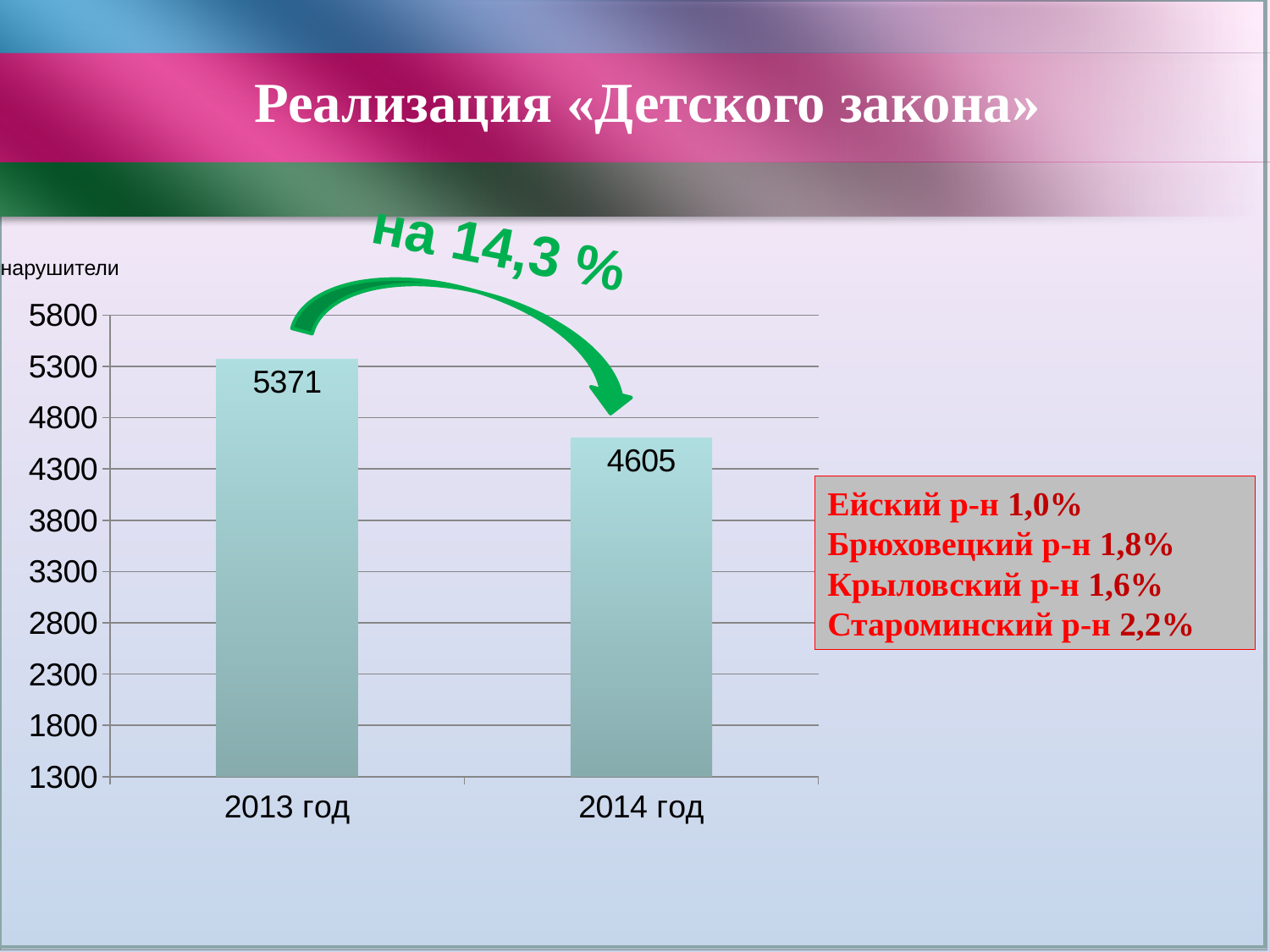
Do the values rise or fall from 2013 год to 2014 год? fall Is the value for 2013 год greater or less than 5300? greater What percentage change is written above the arrow on the chart? на 14,3 % What is the label of the vertical axis? нарушители Which year has the lower value? 2014 год What is the difference between the values for 2013 год and 2014 год? 766 What kind of chart is shown on the slide? bar chart What is the value for 2013 год? 5371 Is the value for 2014 год greater or less than 4800? less Which year has the higher value? 2013 год How many bars are shown in the chart? 2 What is the value for 2014 год? 4605